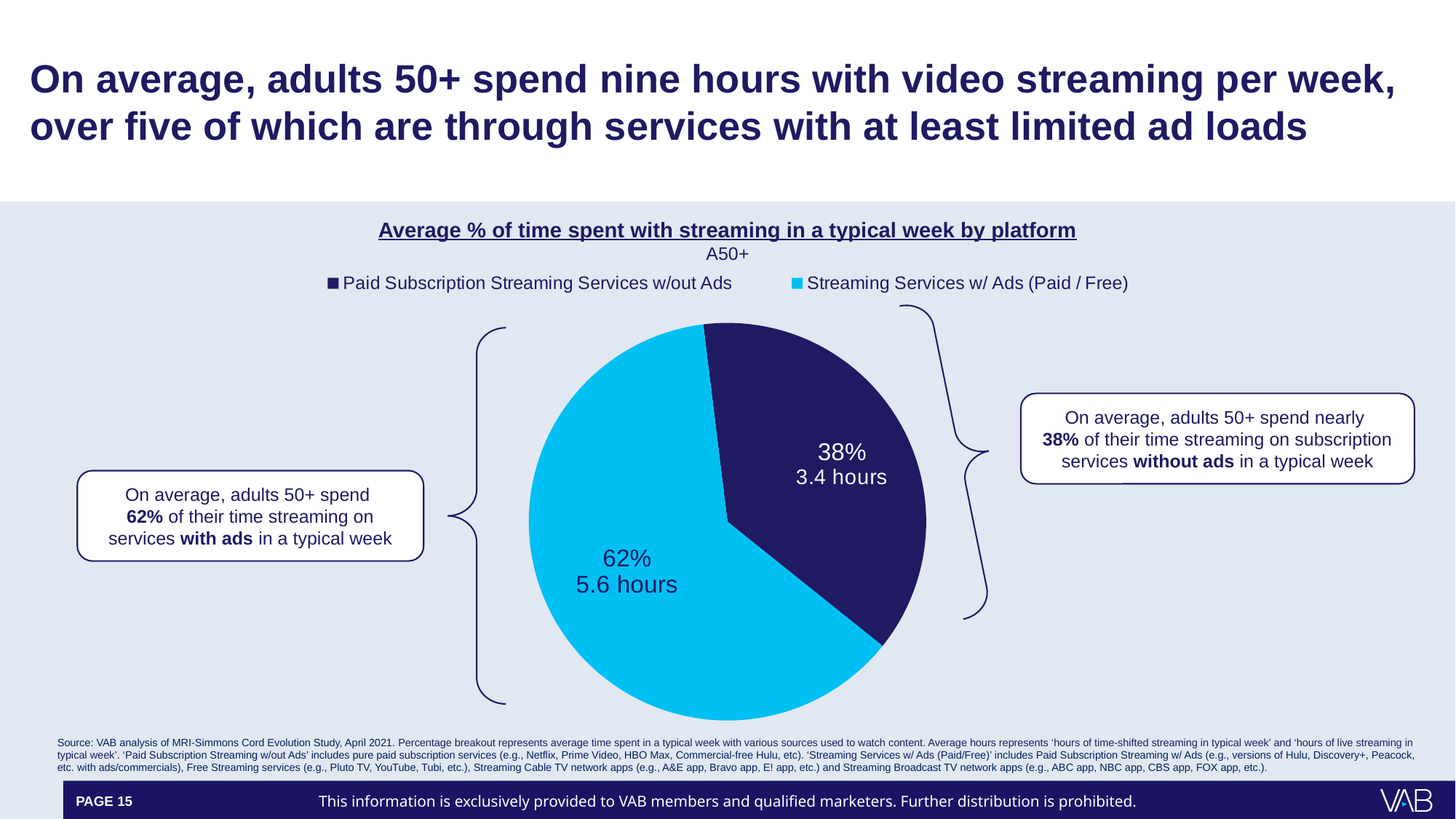
What type of chart is shown on the slide? Pie chart How many hours per week do adults 50+ spend on Paid Subscription Streaming Services w/out Ads? 3.4 hours Which slice of the pie is the largest? Streaming Services w/ Ads (Paid / Free) What is the difference in hours between Streaming Services w/ Ads (5.6 hours) and Paid Subscription Streaming Services w/out Ads (3.4 hours)? 2.2 hours What percentage of streaming time do adults 50+ spend on Paid Subscription Streaming Services w/out Ads? 38% What is the difference in percentage points between the Streaming Services w/ Ads slice and the Paid Subscription Streaming Services w/out Ads slice? 24 percentage points Which is larger: the share for Streaming Services w/ Ads or the share for Paid Subscription Streaming Services w/out Ads? Streaming Services w/ Ads How many hours per week do adults 50+ spend on Streaming Services w/ Ads (Paid / Free)? 5.6 hours What percentage of streaming time do adults 50+ spend on Streaming Services w/ Ads (Paid / Free)? 62% Which slice of the pie is the smallest? Paid Subscription Streaming Services w/out Ads How many slices does the pie chart have? 2 What is the title of the chart? Average % of time spent with streaming in a typical week by platform